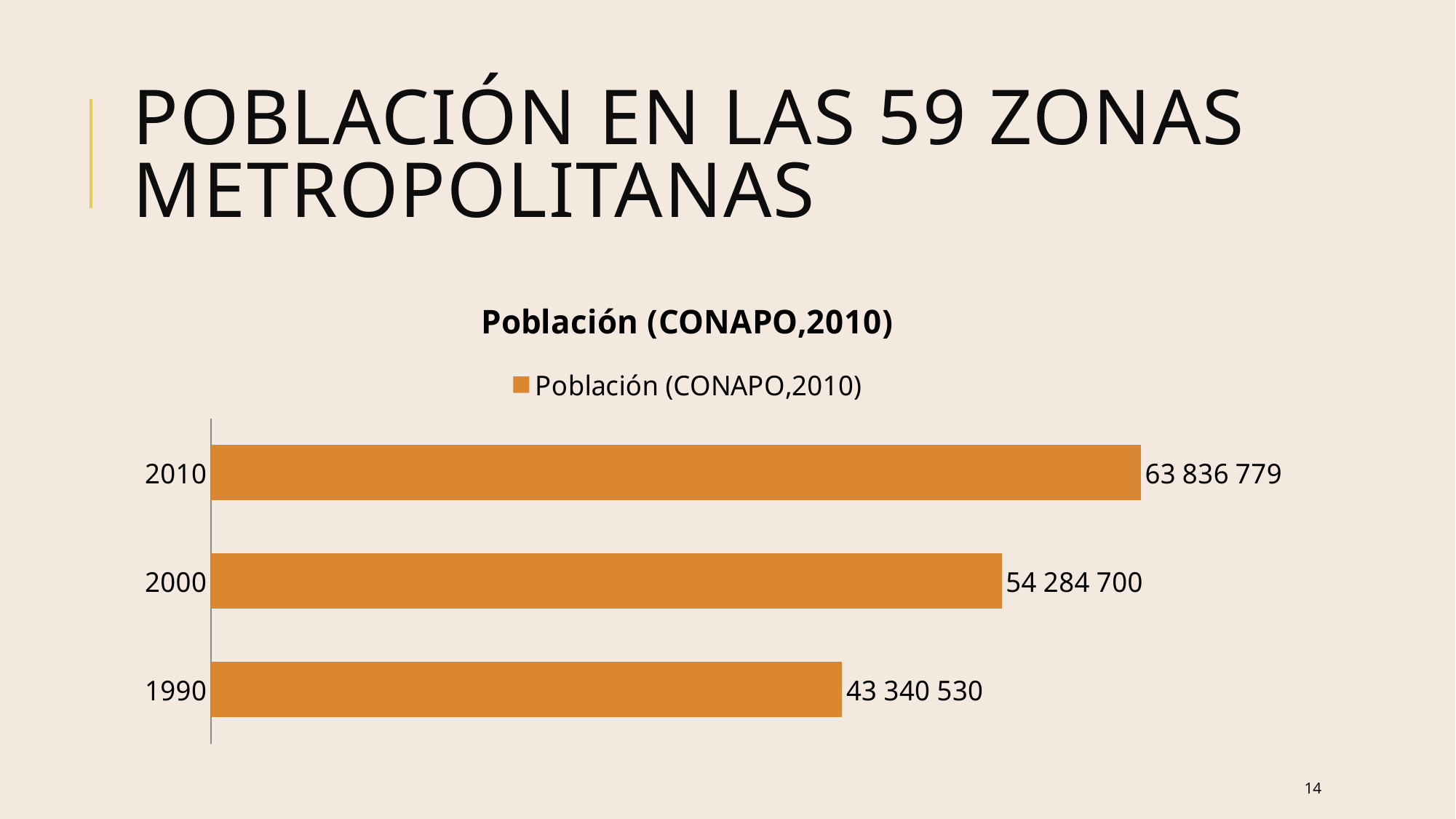
Which year has the highest population value? 2010 How many series does the legend list? 1 What is the population value shown for 2000? 54 284 700 How many years are shown in the chart? 3 Does the population rise or fall from 1990 to 2010? Rise Which year has a larger population value, 2000 or 1990? 2000 Which year has the lowest population value? 1990 What is the difference between the population values for 2010 and 2000? 9 552 079 What is the population value shown for 2010? 63 836 779 What is the population value shown for 1990? 43 340 530 What kind of chart is shown on the slide? Bar chart What is the difference between the population values for 2000 and 1990? 10 944 170